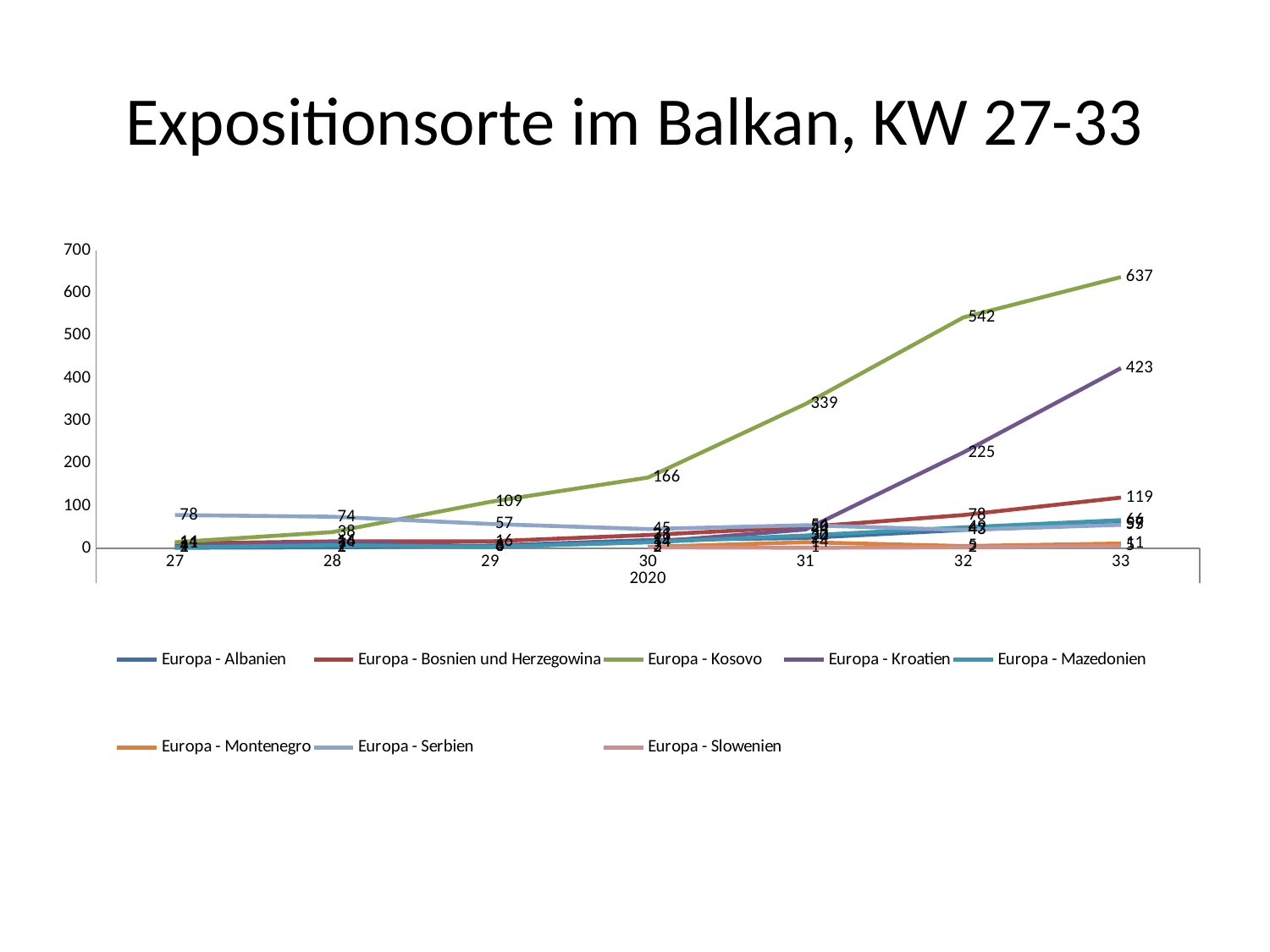
What is the value for Europa - Serbien in week 27? 78 What is the difference between the Europa - Kosovo values in week 33 and week 32? 95 Which is larger: Europa - Kosovo in week 31 or Europa - Kroatien in week 32? Europa - Kosovo in week 31 What is the value for Europa - Kosovo in week 33? 637 Which series has the highest value in week 33? Europa - Kosovo How many series does the legend list? 8 What kind of chart is shown on the slide? line chart What is the value for Europa - Kroatien in week 33? 423 How many calendar weeks are plotted along the x axis? 7 What is the value for Europa - Kosovo in week 32? 542 What is the value for Europa - Kroatien in week 32? 225 Does the Europa - Kosovo line rise or fall from week 27 to week 33? rise